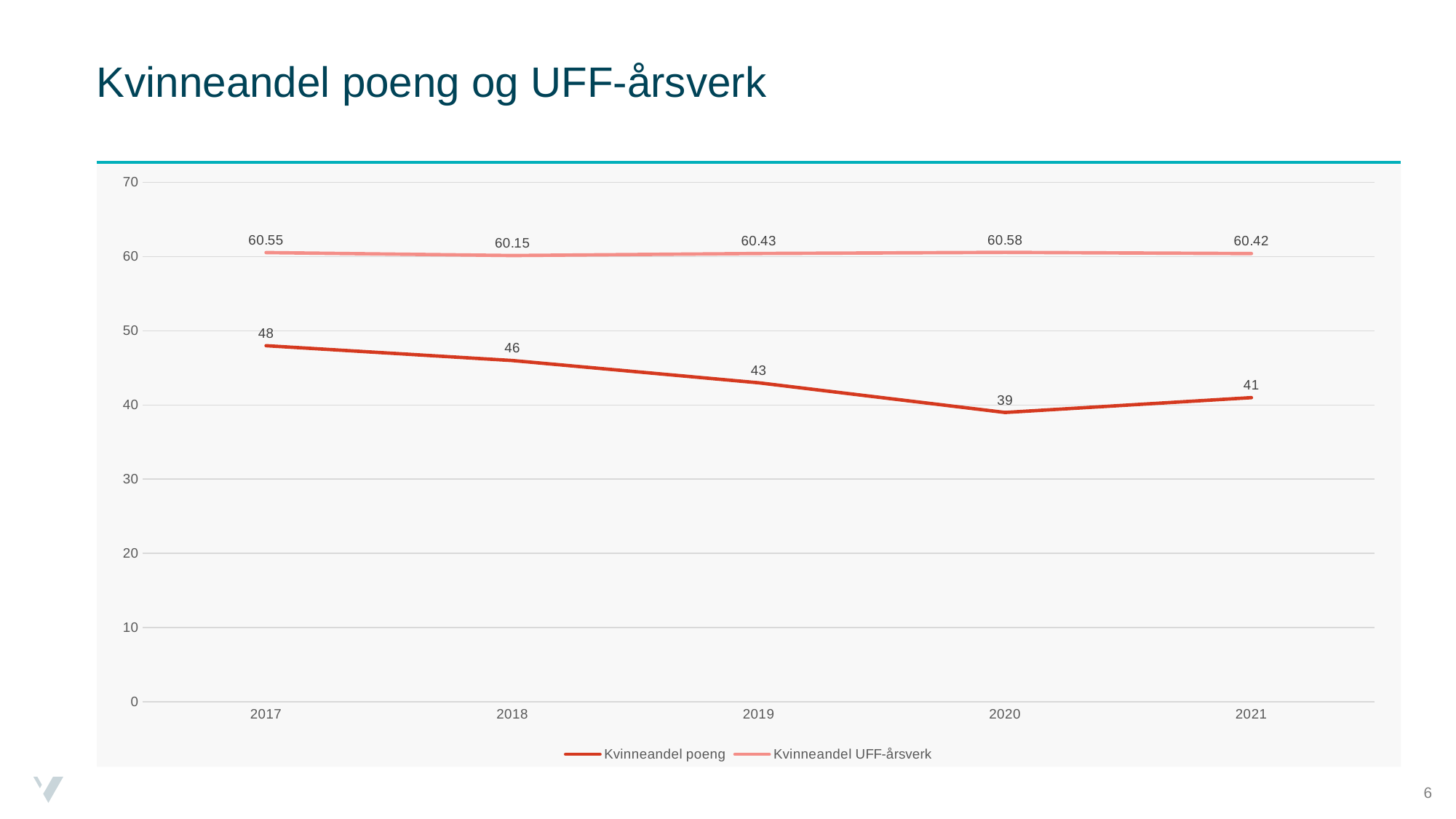
In which year is Kvinneandel poeng highest? 2017 What is the value of Kvinneandel poeng in 2020? 39 What kind of chart is shown on the slide? Line chart What is the difference between Kvinneandel poeng in 2017 and 2020? 9 What is the value of Kvinneandel UFF-årsverk in 2018? 60.15 In which year is Kvinneandel poeng lowest? 2020 How many years are shown on the x axis? 5 How many series does the legend list? 2 What is the value of Kvinneandel poeng in 2017? 48 What is the value of Kvinneandel UFF-årsverk in 2020? 60.58 Which is larger in 2019: Kvinneandel poeng or Kvinneandel UFF-årsverk? Kvinneandel UFF-årsverk What is the difference between Kvinneandel UFF-årsverk and Kvinneandel poeng in 2021? 19.42